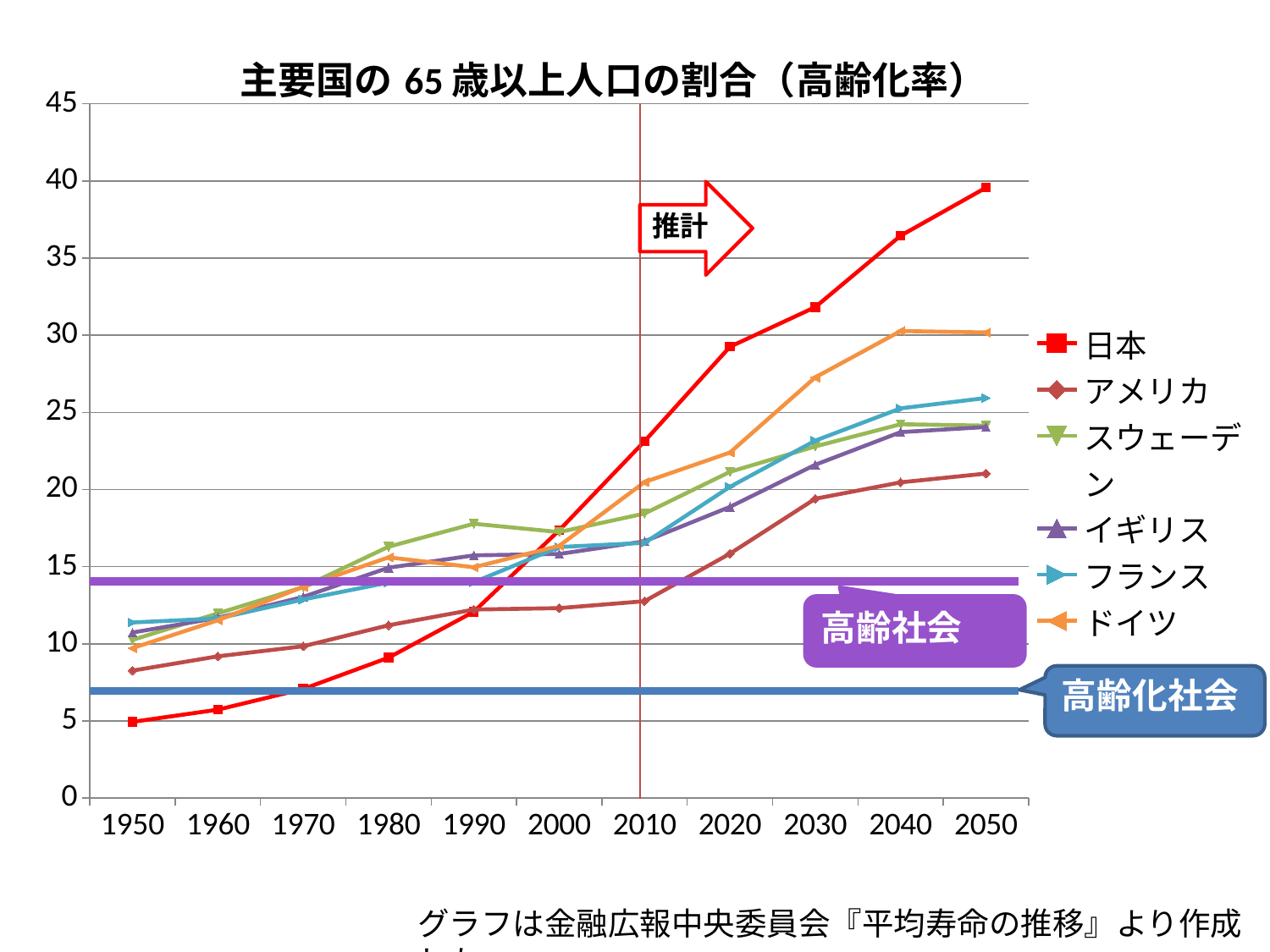
How many series does the legend list? 6 Is the value for 日本 in 2050 greater or less than 35? greater Is the value for 日本 in 2010 greater or less than 20? greater What kind of chart is shown on the slide? line chart Is the value for ドイツ in 2030 greater or less than 25? greater Which country has the lowest value in 2050? アメリカ In 1950, which is larger: the value for 日本 or the value for アメリカ? アメリカ How many years are plotted along the x axis? 11 Which country has the highest value in 2050? 日本 Does the value for 日本 rise or fall from 1950 to 2050? rise Which country has the lowest value in 1950? 日本